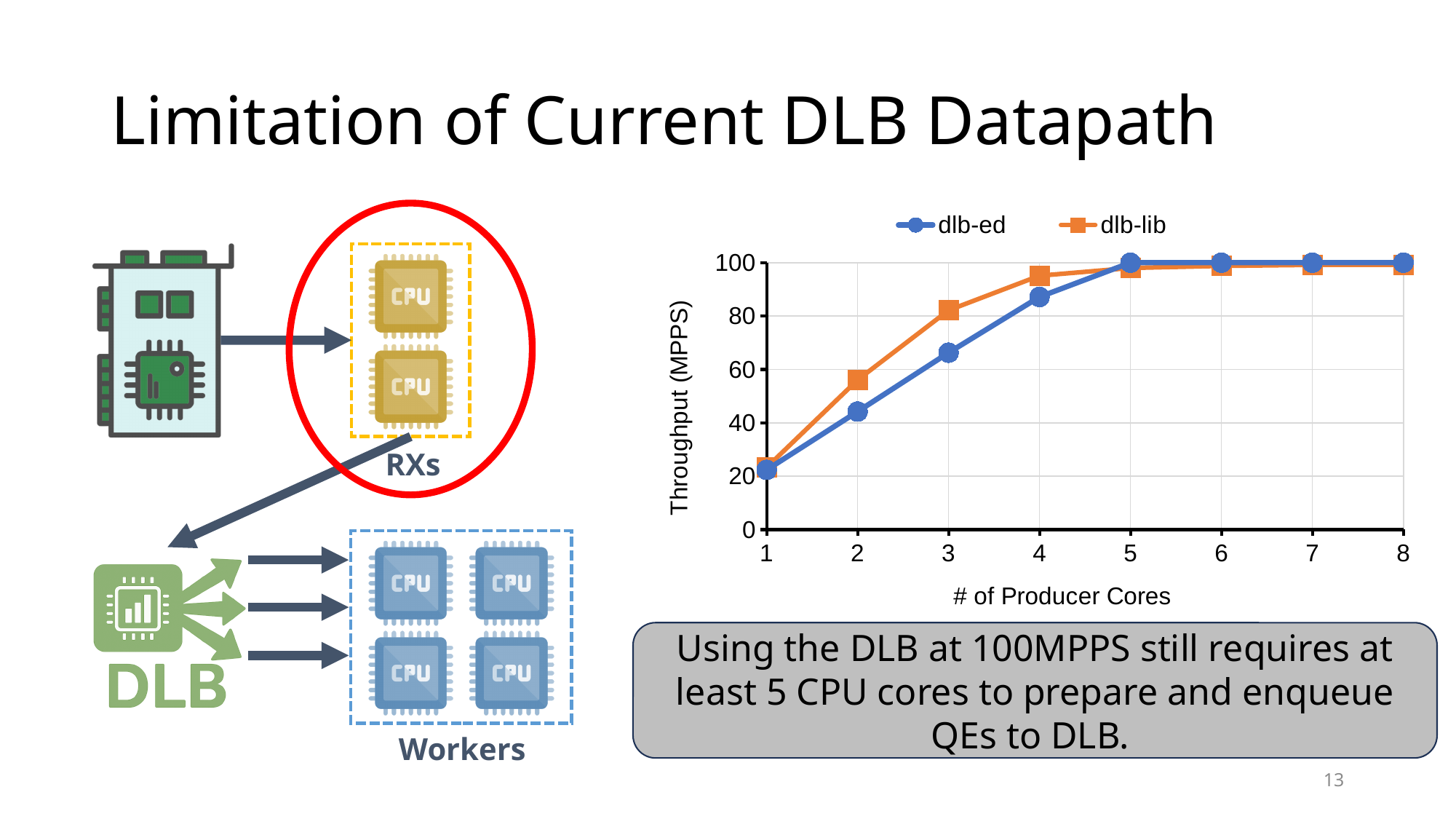
What is the label of the x axis? # of Producer Cores At 2 producer cores, which series has the higher throughput, dlb-ed or dlb-lib? dlb-lib Is the throughput for dlb-lib at 3 producer cores greater or less than 60? greater What is the label of the y axis? Throughput (MPPS) At 3 producer cores, which series has the higher throughput, dlb-ed or dlb-lib? dlb-lib Is the throughput for dlb-ed at 4 producer cores greater or less than 80? greater How many producer-core values are plotted along the x axis? 8 Is the throughput for dlb-ed at 2 producer cores greater or less than 60? less How many series does the chart legend list? 2 What kind of chart is shown on the slide? line chart Does the throughput of dlb-ed rise or fall as the number of producer cores increases from 1 to 5? rise